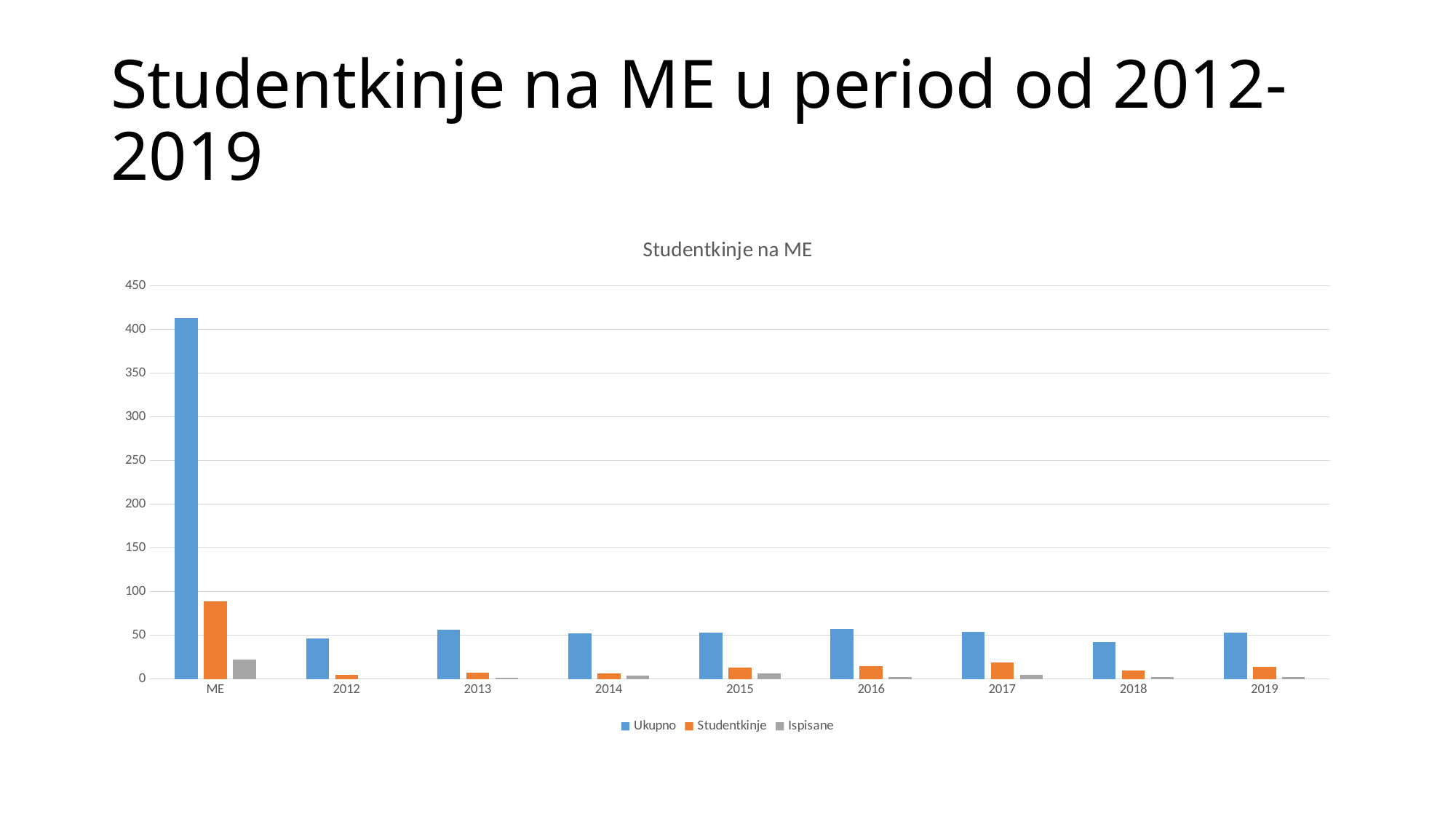
What kind of chart is shown on the slide? bar chart Which category has the highest Ukupno value? ME Which is larger, the Studentkinje value for 2017 or for 2012? 2017 Among the years 2012 to 2019, which year has the highest Studentkinje value? 2017 How many series does the legend list? 3 What is the title of the chart? Studentkinje na ME Is the Ukupno value for 2018 greater or less than 50? less Is the Studentkinje value for ME greater or less than 100? less Is the Ukupno value for ME greater or less than 400? greater How many categories are shown on the x axis? 9